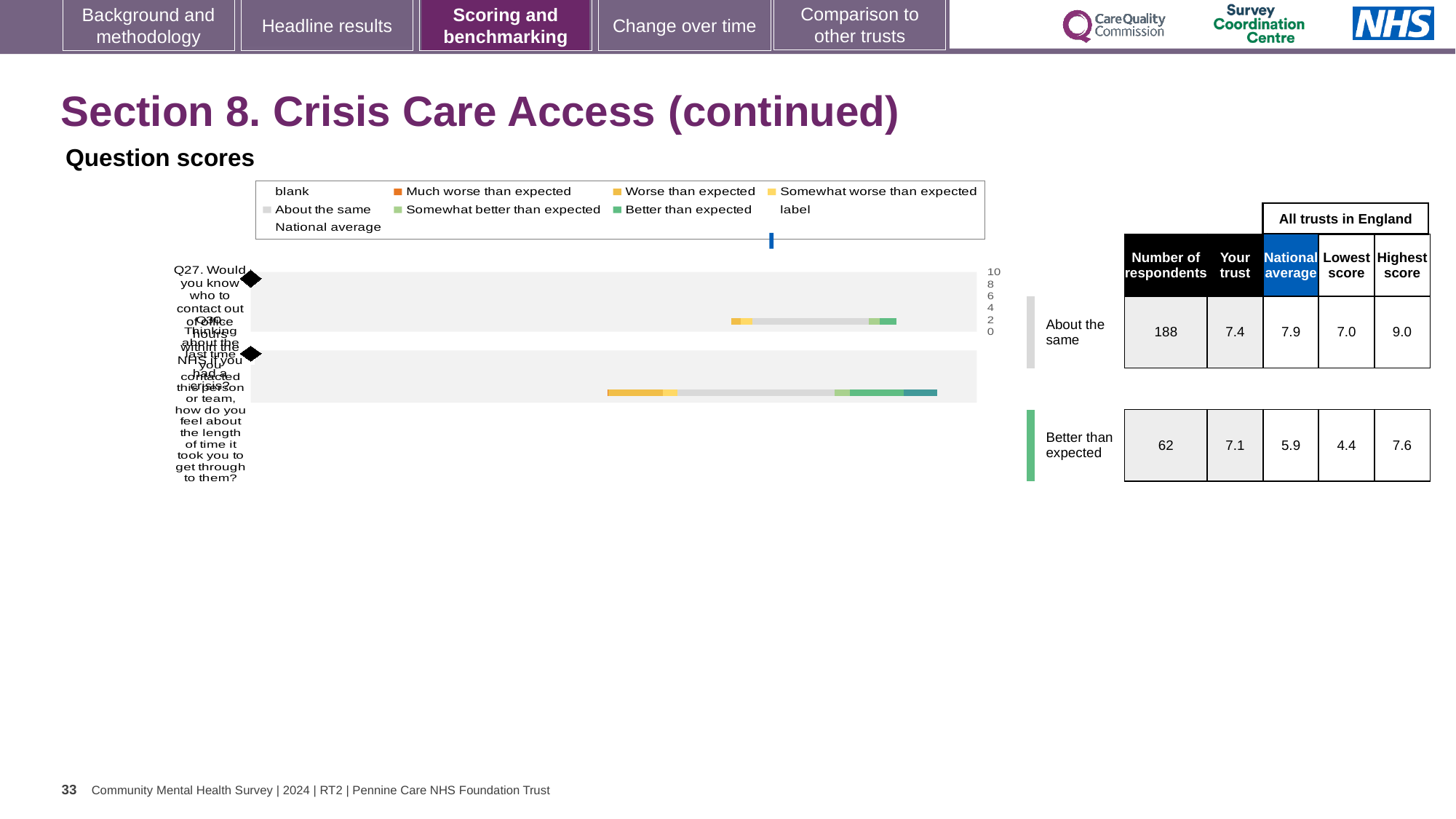
What is the 'Your trust' score for Q30? 7.1 What is the national average score for Q27? 7.9 Which question has the higher 'Your trust' score, Q27 or Q30? Q27 What is the 'Your trust' score for Q27? 7.4 How many questions are plotted in the question scores chart? 2 What benchmark category is Q30 rated as? Better than expected What is the lowest score among all trusts in England for Q30 (length of time it took to get through)? 4.4 What is the highest score among all trusts in England for Q27? 9.0 What kind of chart is used to show the question scores on this slide? Bar chart What benchmark category is Q27 rated as? About the same What is the difference between the trust score and the national average for Q30? 1.2 What is the number of respondents for Q27 (would you know who to contact out of office hours)? 188